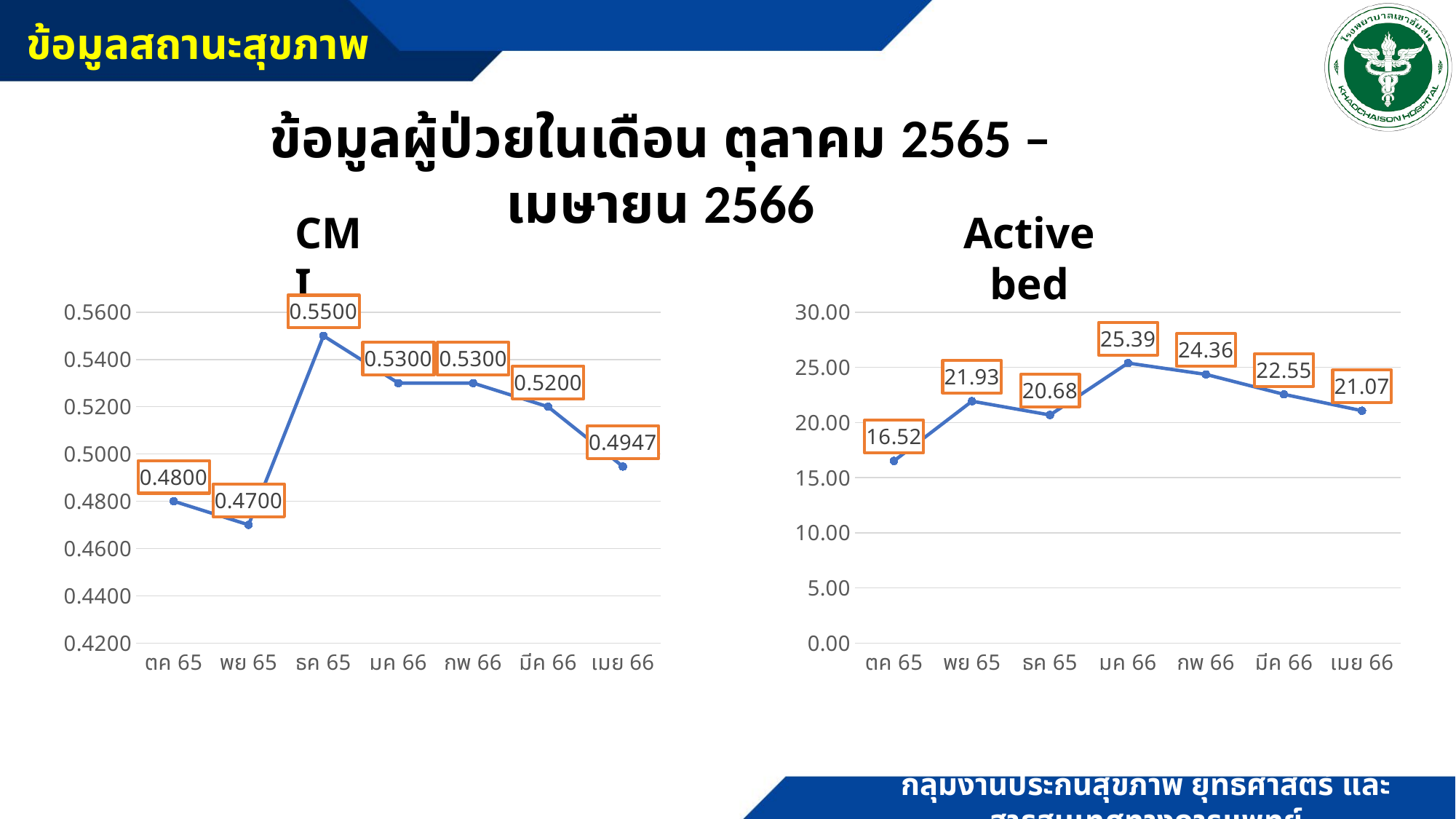
In the Active bed chart, what is the value for มค 66? 25.39 In the CMI chart, what is the value for เมย 66? 0.4947 In the CMI chart, which month has the lowest value? พย 65 In the Active bed chart, do the values rise or fall from มค 66 to เมย 66? fall In the Active bed chart, which is larger, the value for พย 65 or the value for ธค 65? พย 65 In the CMI chart, what is the difference between the values for ธค 65 and พย 65? 0.0800 In the CMI chart, what is the value for ธค 65? 0.5500 In the Active bed chart, which month has the highest value? มค 66 In the CMI chart, how many data points are plotted? 7 What kind of chart is the CMI chart? line chart In the Active bed chart, what is the difference between the values for มค 66 and ตค 65? 8.87 In the Active bed chart, which month has the lowest value? ตค 65